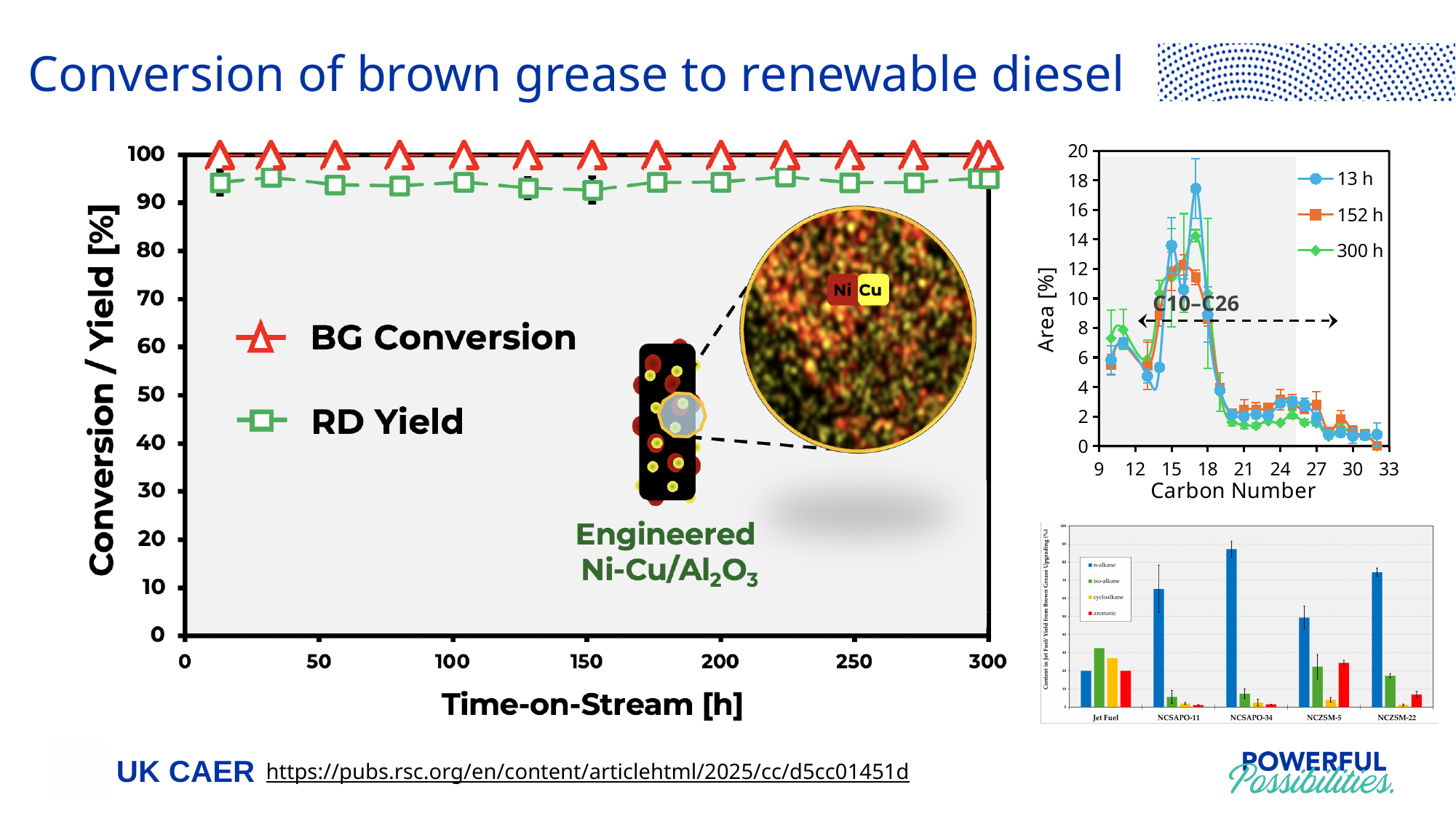
On the left chart (Conversion / Yield vs Time-on-Stream), which series is higher at 150 h, BG Conversion or RD Yield? BG Conversion On the bottom-right bar chart, is the n-alkane value for NCSAPO-34 greater or less than 80? greater On the bottom-right bar chart, how many categories are shown on the x axis? 5 On the bottom-right bar chart, which category has the highest n-alkane value? NCSAPO-34 On the top-right chart (Area vs Carbon Number), how many series does the legend list? 3 On the left chart (Conversion / Yield vs Time-on-Stream), how many series does the legend list? 2 On the top-right chart (Area vs Carbon Number), at which carbon number does the 13 h series reach its highest area? 17 On the left chart (Conversion / Yield vs Time-on-Stream), what kind of chart is it? Line chart On the left chart (Conversion / Yield vs Time-on-Stream), what is the label of the x axis? Time-on-Stream [h] On the top-right chart (Area vs Carbon Number), is the 13 h value at carbon number 17 greater or less than 16? greater On the top-right chart (Area vs Carbon Number), which series is larger at carbon number 17, 13 h or 152 h? 13 h